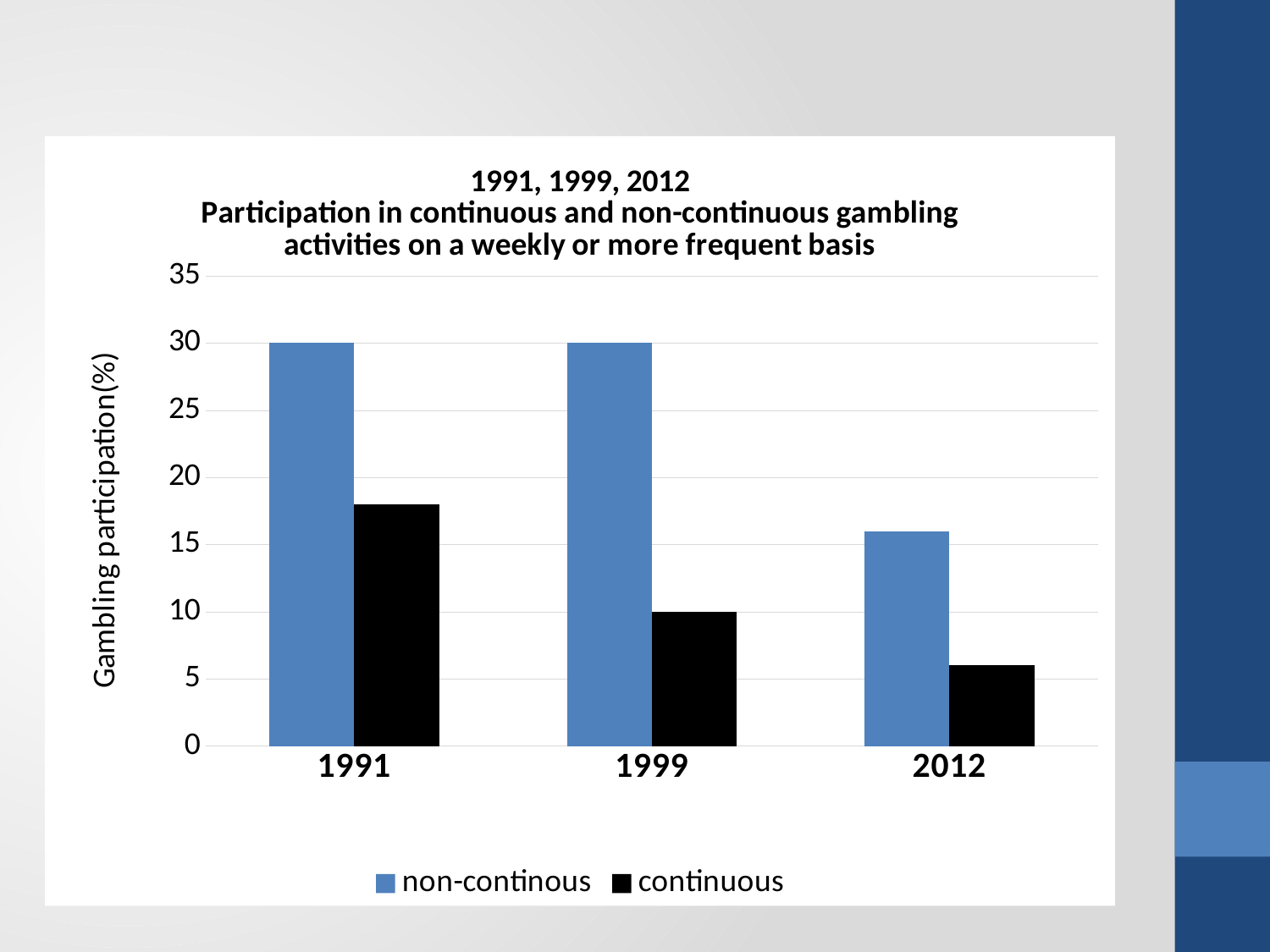
What is the non-continuous gambling participation value for 1999? 30 How many series does the legend list? 2 What is the non-continuous gambling participation value for 1991? 30 Is the continuous value for 2012 greater or less than 10? less Is the continuous value for 1991 greater or less than 15? greater How many years are shown on the x axis? 3 What is the continuous gambling participation value for 1999? 10 Do the continuous gambling participation values rise or fall from 1991 to 2012? fall What is the difference between the non-continuous and continuous values in 1999? 20 Which year has the highest continuous gambling participation? 1991 What type of chart is shown on the slide? bar chart Which year has the lowest non-continuous gambling participation? 2012